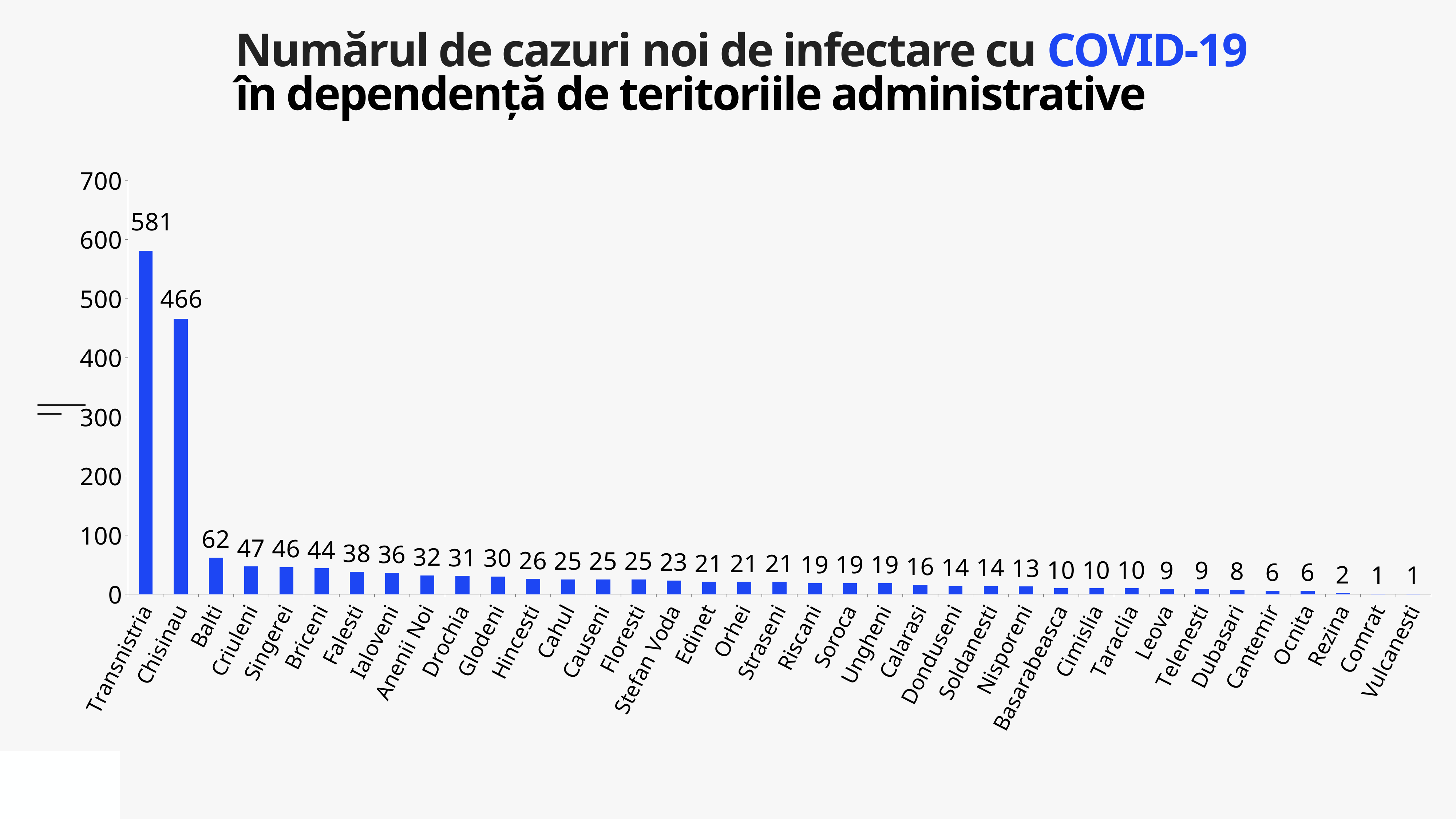
Which is larger, the value for Falesti or the value for Ialoveni? Falesti How many territories are shown on the x axis? 37 What is the value for Chisinau? 466 What is the value for Hincesti? 26 What is the difference between the values for Transnistria and Chisinau? 115 What is the difference between the values for Balti and Criuleni? 15 Which territory has the highest number of new cases? Transnistria Is the value for Chisinau greater or less than 400? greater What kind of chart is shown on the slide? Bar chart What is the value for Nisporeni? 13 What is the value for Balti? 62 What is the value for Transnistria? 581